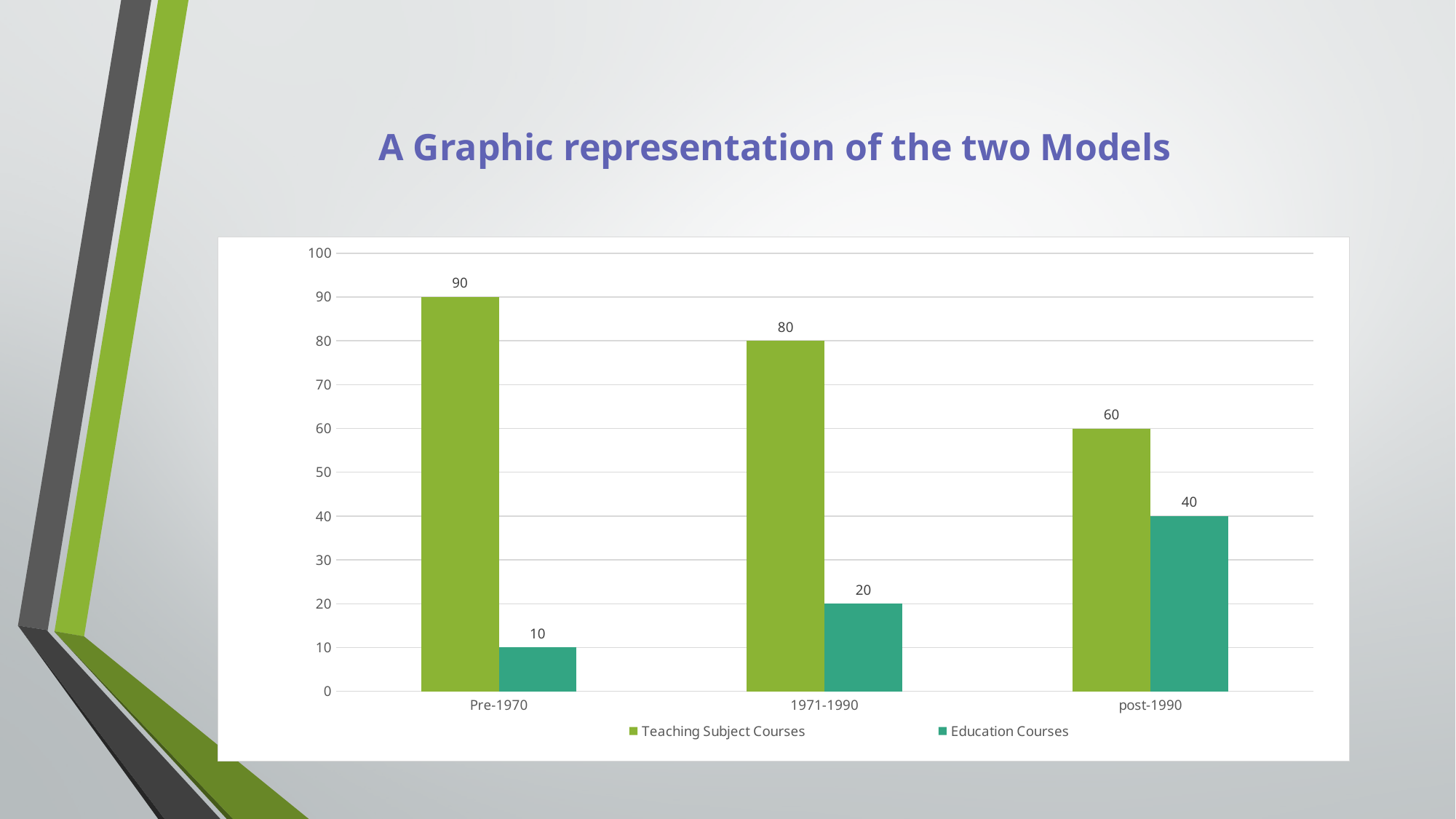
How many series does the legend list? 2 How many periods are shown on the x axis? 3 What is the value for Education Courses in post-1990? 40 What kind of chart is shown on the slide? Bar chart Which is larger in 1971-1990: Teaching Subject Courses or Education Courses? Teaching Subject Courses What is the value for Teaching Subject Courses in Pre-1970? 90 What is the value for Education Courses in 1971-1990? 20 Which period has the lowest value for Education Courses? Pre-1970 Which period has the highest value for Teaching Subject Courses? Pre-1970 What is the difference between Teaching Subject Courses and Education Courses in post-1990? 20 Do the values for Education Courses rise or fall from Pre-1970 to post-1990? Rise What is the title of the slide? A Graphic representation of the two Models